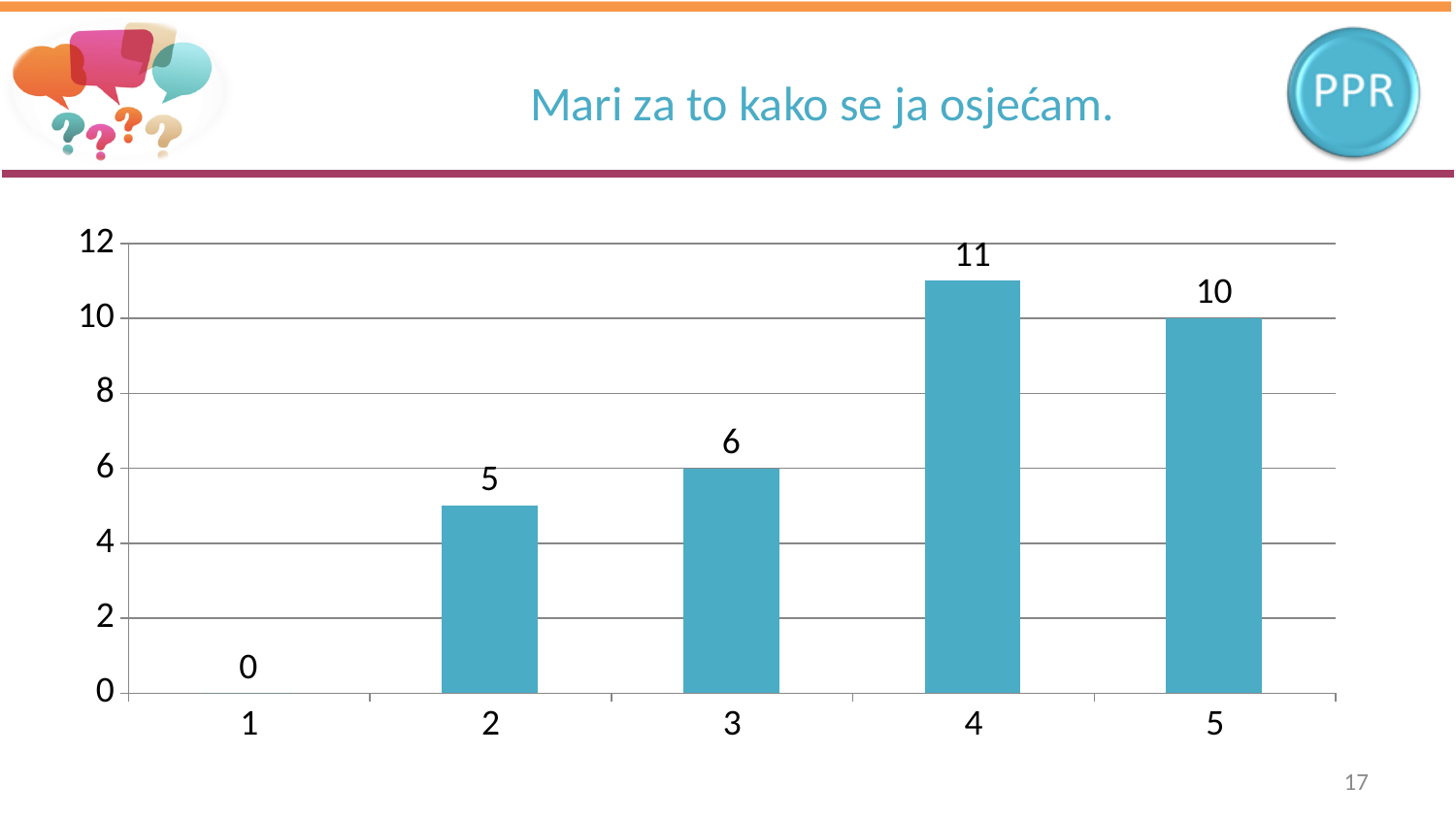
What is the value for category 5? 10 What is the difference between the values for category 4 and category 3? 5 What is the title of the slide containing the chart? Mari za to kako se ja osjećam. What is the value for category 2? 5 Is the value for category 4 greater or less than 8? greater What is the value for category 4? 11 What is the value for category 1? 0 Which category has the lowest value? 1 Which category has the highest value? 4 How many categories are shown on the x axis? 5 What kind of chart is shown on the slide? bar chart Which is larger, the value for category 3 or the value for category 5? category 5